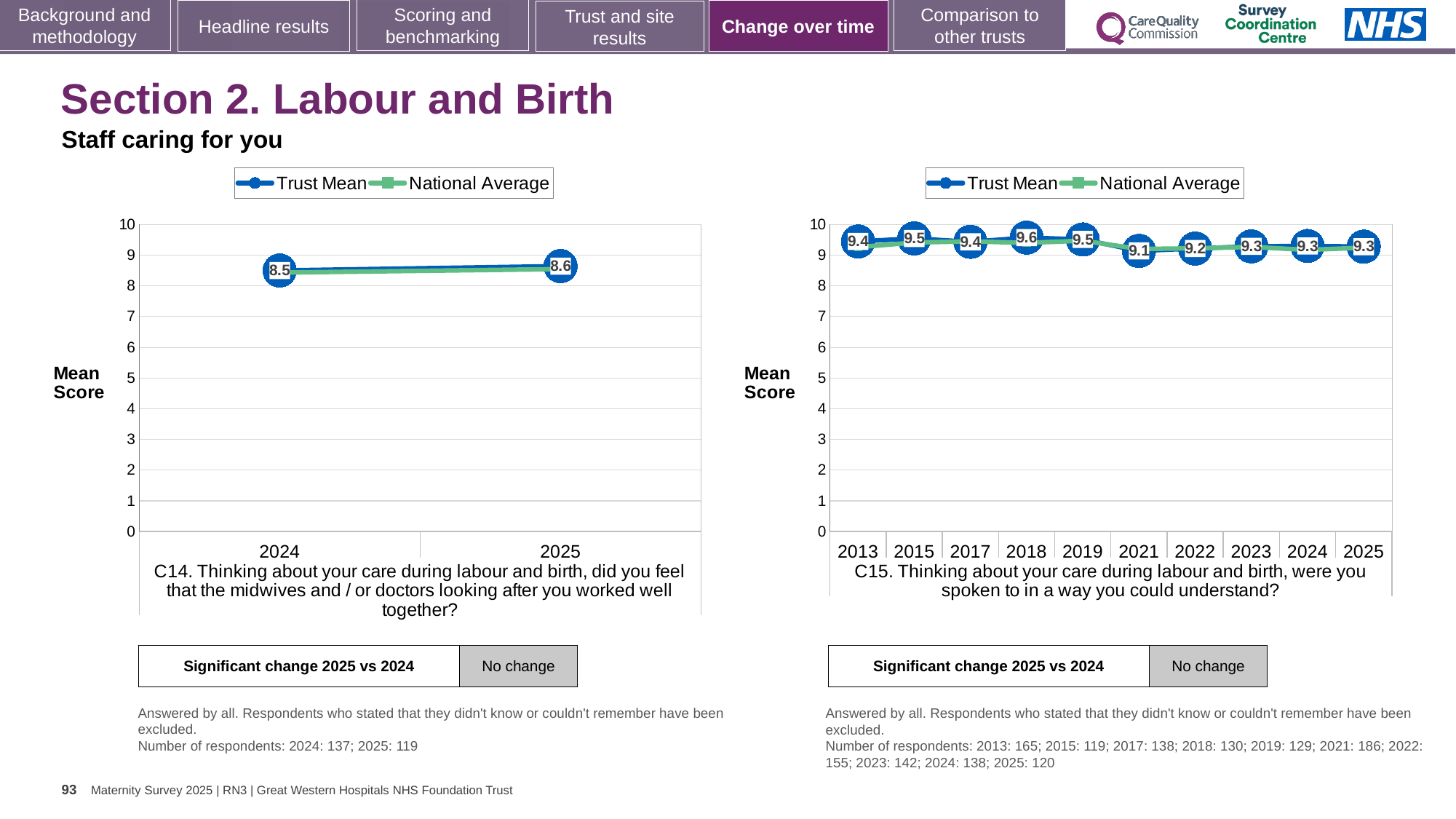
On the left chart (C14), what is the Trust Mean score for 2025? 8.6 On the right chart (C15), which year has the lowest Trust Mean score? 2021 How many series does the legend of the right chart (C15) list? 2 On the right chart (C15), what is the difference between the Trust Mean scores for 2018 and 2021? 0.5 On the right chart (C15), which year has the highest Trust Mean score? 2018 On the left chart (C14), what is the difference between the Trust Mean scores for 2025 and 2024? 0.1 On the left chart (C14), how many years are plotted on the x axis? 2 On the right chart (C15), what is the Trust Mean score for 2018? 9.6 On the left chart (C14), what is the Trust Mean score for 2024? 8.5 On the right chart (C15), how many years are plotted on the x axis? 10 What type of chart is the left chart (C14)? Line chart On the right chart (C15), what is the Trust Mean score for 2021? 9.1